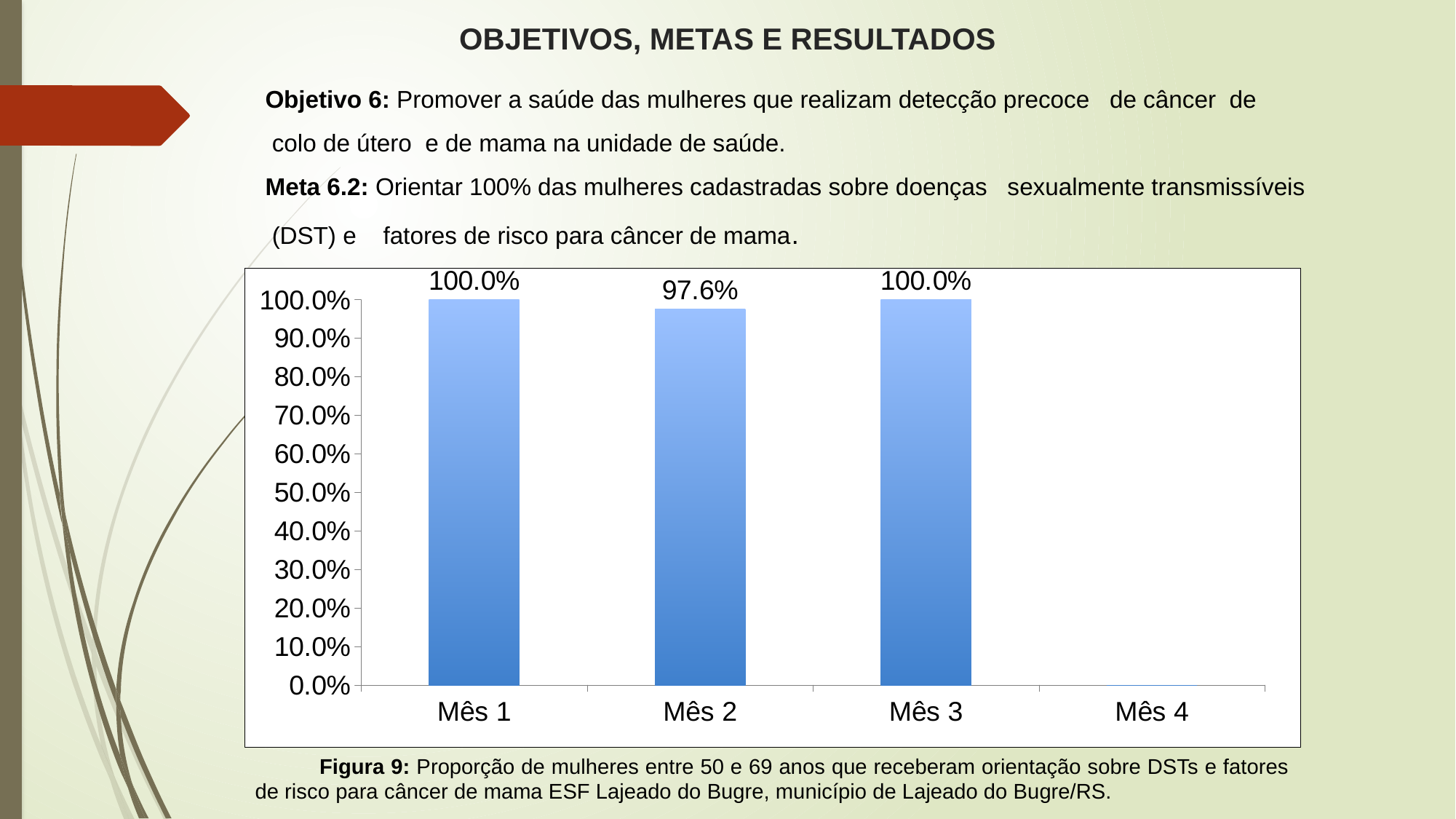
What is the difference between the values for Mês 1 and Mês 2? 2.4% How many categories are shown on the x axis? 4 Among the months that have a bar, which has the lowest value? Mês 2 What is the value for Mês 2? 97.6% What kind of chart is shown on the slide? bar chart Is the value for Mês 2 greater or less than 90.0%? greater What is the value for Mês 1? 100.0% What is the value for Mês 3? 100.0% Which month on the x axis has no bar plotted? Mês 4 Which is larger, the value for Mês 2 or the value for Mês 3? Mês 3 Does the value rise or fall from Mês 1 to Mês 2? fall What figure number is given in the caption below the chart? Figura 9